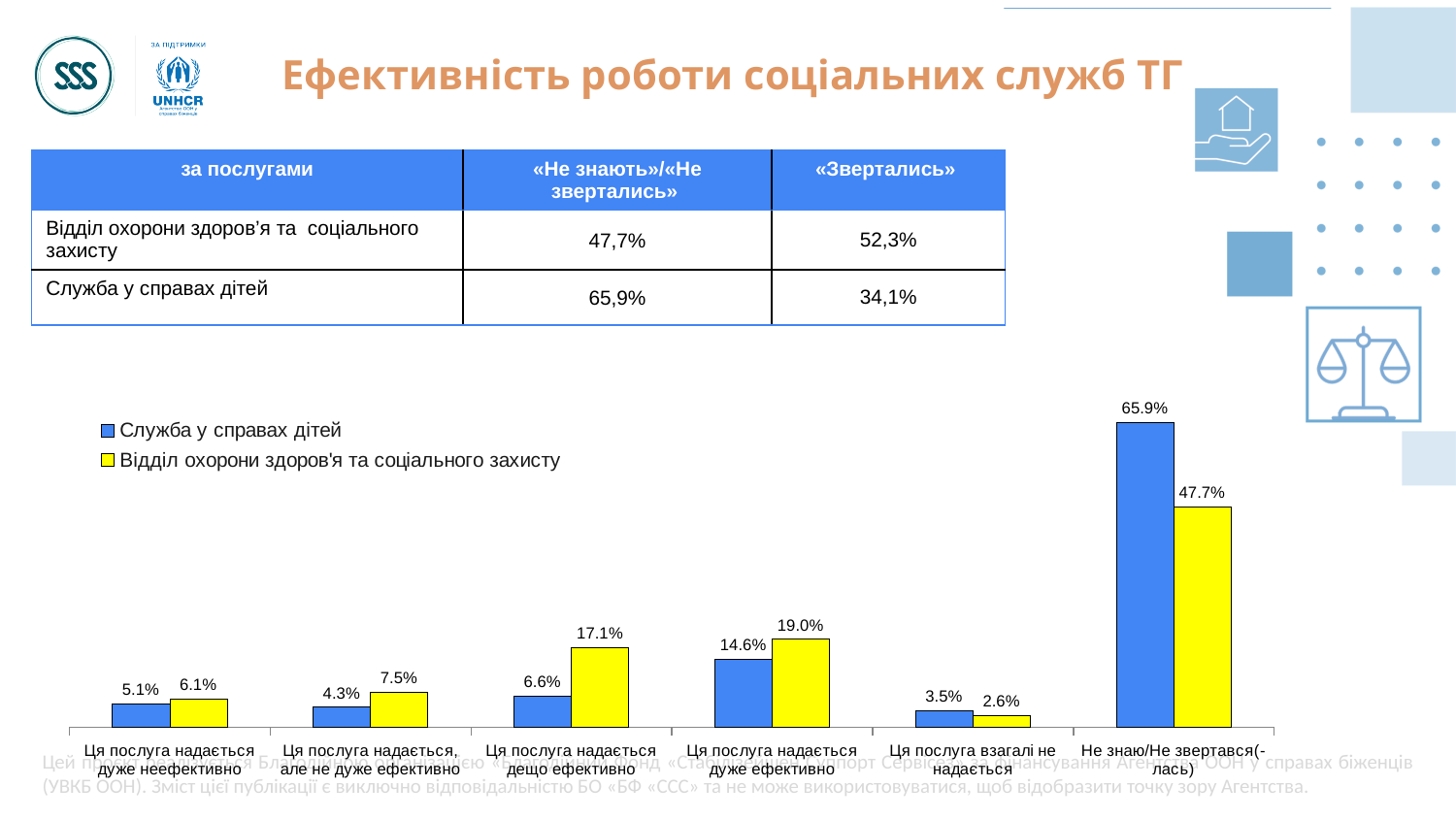
Which category has the highest value for «Служба у справах дітей»? Не знаю/Не звертався(-лась) How many categories are shown along the x axis of the chart? 6 What is the value for «Відділ охорони здоров'я та соціального захисту» in the category «Ця послуга надається дещо ефективно»? 17.1% Which category has the lowest value for «Відділ охорони здоров'я та соціального захисту»? Ця послуга взагалі не надається In the category «Ця послуга надається дуже ефективно», which series has the larger value? Відділ охорони здоров'я та соціального захисту Which series is shown in yellow in the chart? Відділ охорони здоров'я та соціального захисту What is the value for «Відділ охорони здоров'я та соціального захисту» in the category «Ця послуга взагалі не надається»? 2.6% How many series does the chart legend list? 2 What is the value for «Служба у справах дітей» in the category «Не знаю/Не звертався(-лась)»? 65.9% What is the value for «Служба у справах дітей» in the category «Ця послуга надається дуже ефективно»? 14.6% What type of chart is shown on the slide? bar chart What is the difference between the two series in the category «Не знаю/Не звертався(-лась)»? 18.2%